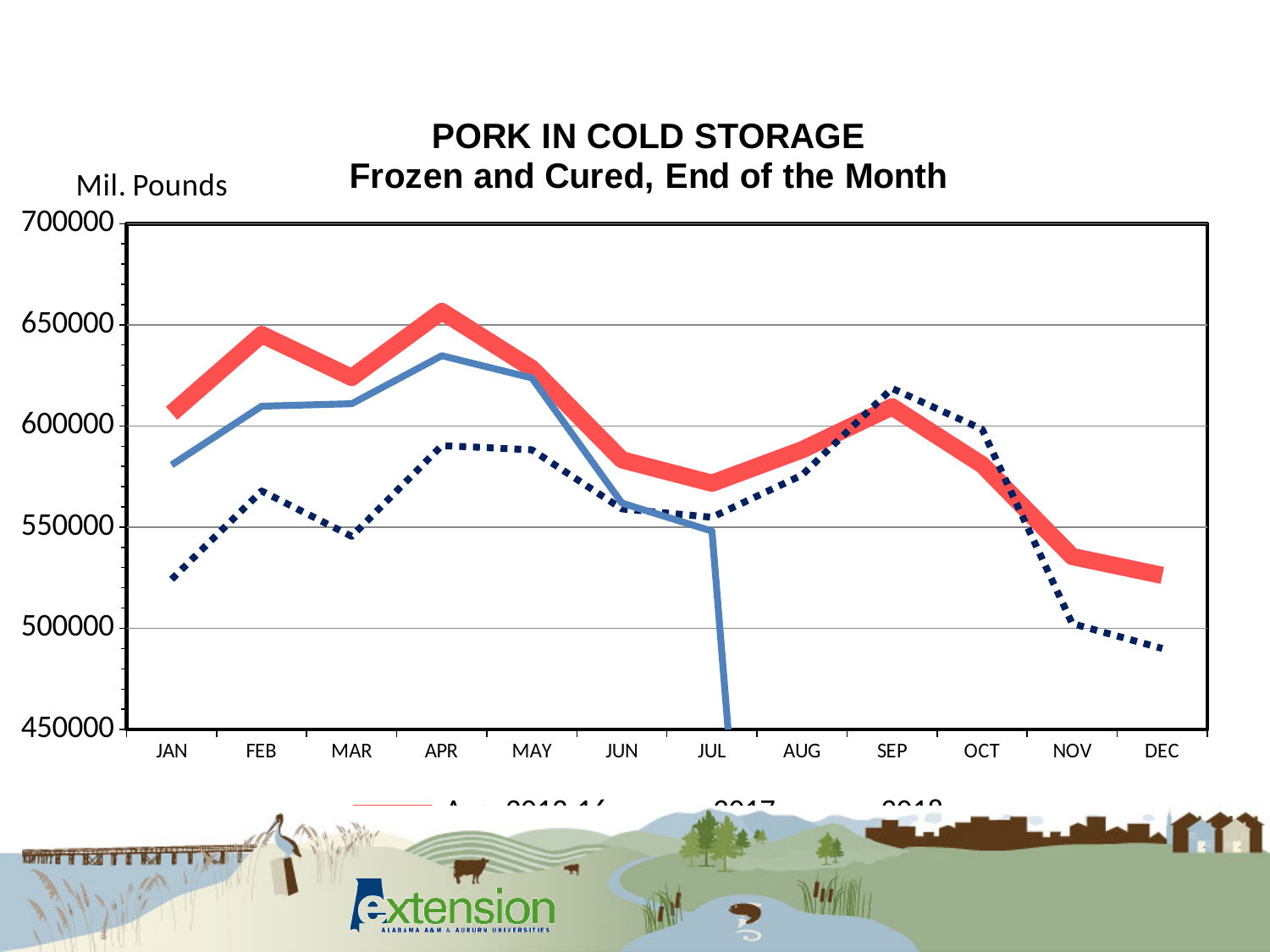
Is the value of the thick red line in APR greater or less than 650000? greater In FEB, which is larger: the thick red line or the dotted navy line? the thick red line Is the value of the solid blue line in APR greater or less than 600000? greater In which month does the dotted navy line reach its highest value? SEP In which month does the thick red line reach its highest value? APR In which month does the dotted navy line reach its lowest value? DEC What kind of chart is shown on the slide? line chart Is the value of the dotted navy line in DEC greater or less than 500000? less How many months are shown along the x axis? 12 How many data series (lines) are plotted on the chart? 3 Does the dotted navy line rise or fall from SEP to DEC? fall